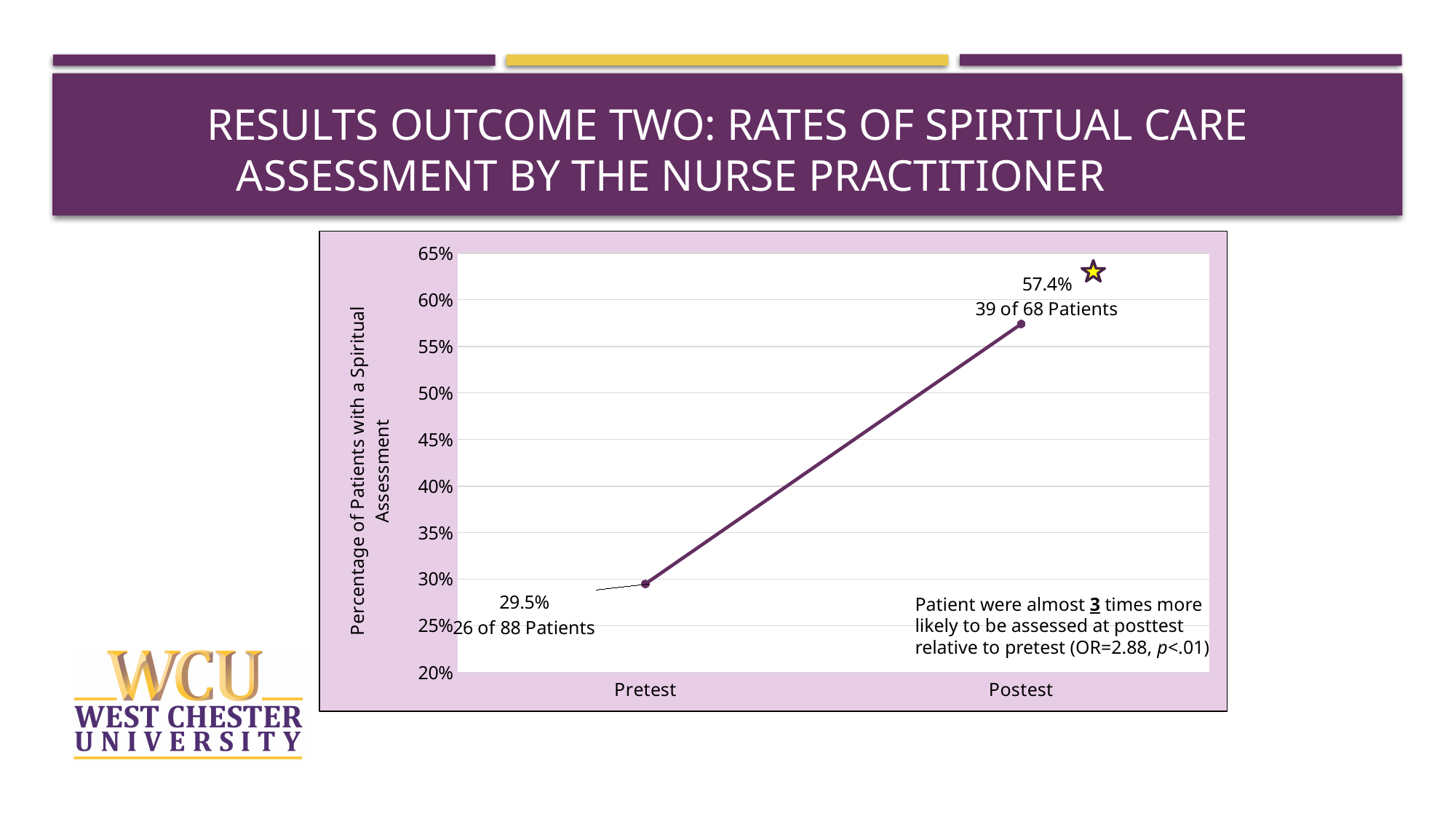
What is the percentage of patients with a spiritual assessment at Pretest? 29.5% How many patients out of how many had a spiritual assessment at Pretest? 26 of 88 Patients Which time point has the lower percentage of patients with a spiritual assessment? Pretest Does the value rise or fall from Pretest to Postest? rise Which time point has the higher percentage of patients with a spiritual assessment? Postest Is the Postest value greater or less than 55%? greater Is the Pretest value greater or less than 30%? less What kind of chart is shown on the slide? line chart What is the percentage of patients with a spiritual assessment at Postest? 57.4% How many data points are plotted on the chart? 2 What is the difference in percentage points between the Postest and Pretest values? 27.9 How many patients out of how many had a spiritual assessment at Postest? 39 of 68 Patients